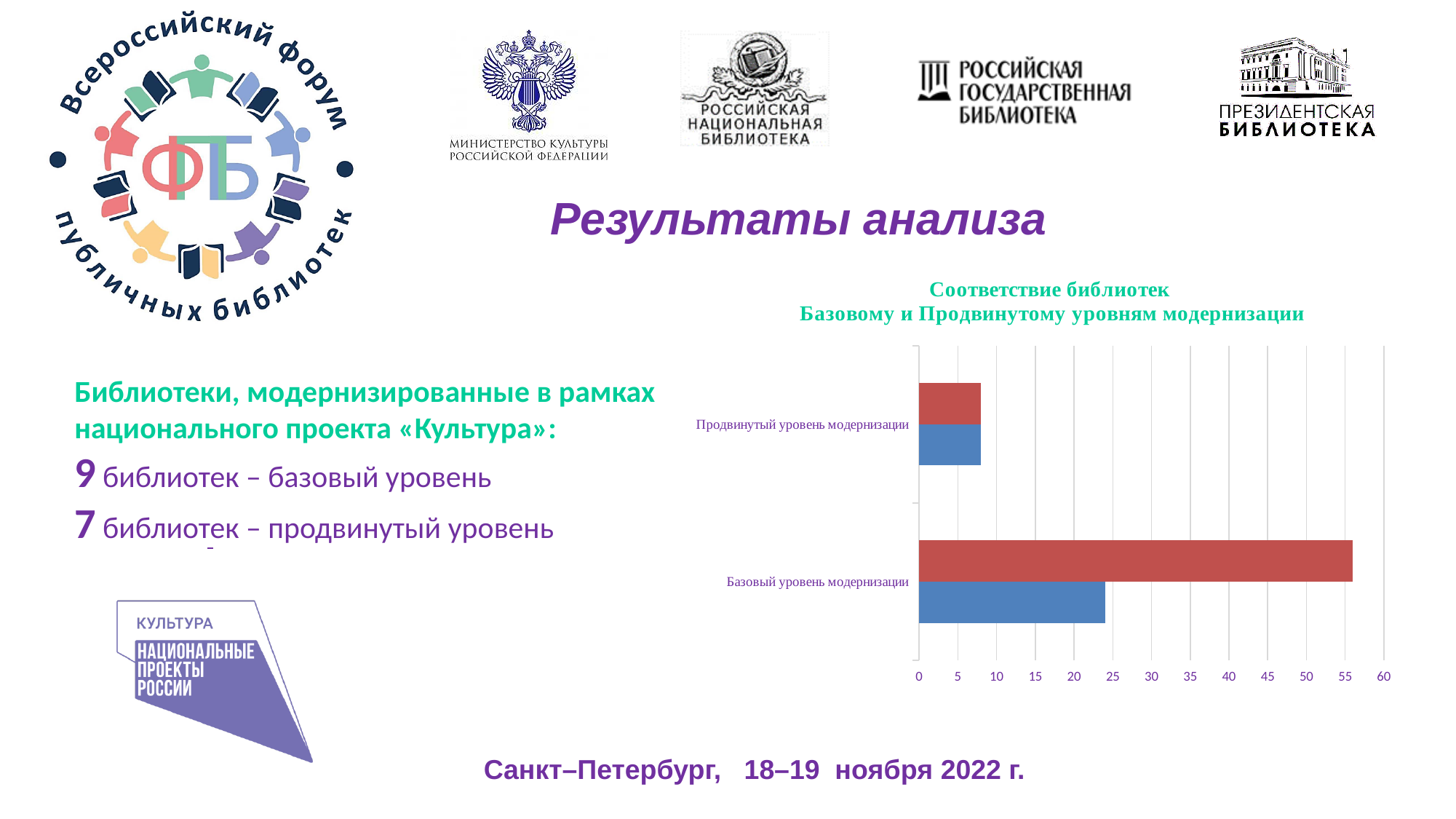
Is the red bar for Базовый уровень модернизации greater or less than 50? greater What kind of chart is shown on the slide? bar chart Which category has the longest bar on the chart? Базовый уровень модернизации Is the red bar for Продвинутый уровень модернизации greater or less than 10? less How many categories are shown on the chart's vertical axis? 2 Is the blue bar for Продвинутый уровень модернизации greater or less than 5? greater For Базовый уровень модернизации, which bar is longer, the red one or the blue one? the red one What is the title of the chart? Соответствие библиотек Базовому и Продвинутому уровням модернизации Which category has the shorter bars on the chart? Продвинутый уровень модернизации What is the highest value shown on the chart's horizontal axis? 60